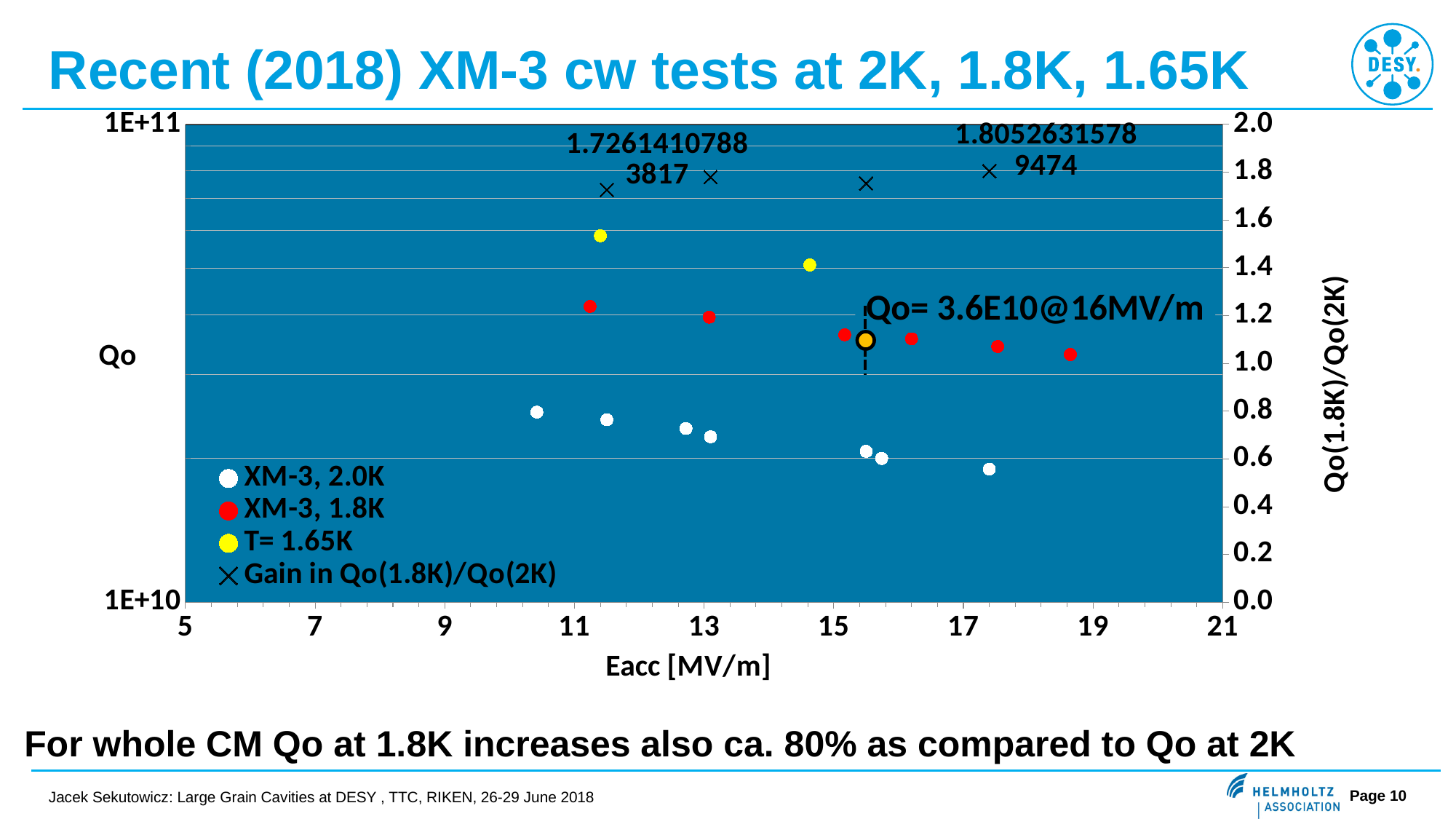
Are the Gain in Qo(1.8K)/Qo(2K) values greater or less than 1.6 on the right axis? greater Which of the two labelled gain values is larger, the one near 11.5 MV/m or the one near 17.5 MV/m? the one near 17.5 MV/m (1.80526315789474) Which series has higher Qo values, XM-3, 1.8K or XM-3, 2.0K? XM-3, 1.8K What is the title of the x axis? Eacc [MV/m] What is the data label printed on the Gain in Qo(1.8K)/Qo(2K) marker near 17.5 MV/m? 1.80526315789474 What Qo value is annotated on the chart at 16 MV/m? 3.6E10 What kind of chart is shown on the slide? scatter chart How many series does the chart legend list? 4 What is the difference between the two labelled gain values, 1.80526315789474 and 1.72614107883817? 0.07912207905657 Do the XM-3, 2.0K Qo values rise or fall as Eacc increases? fall What is the data label printed on the Gain in Qo(1.8K)/Qo(2K) marker near 11.5 MV/m? 1.72614107883817 How many T= 1.65K points are plotted? 2